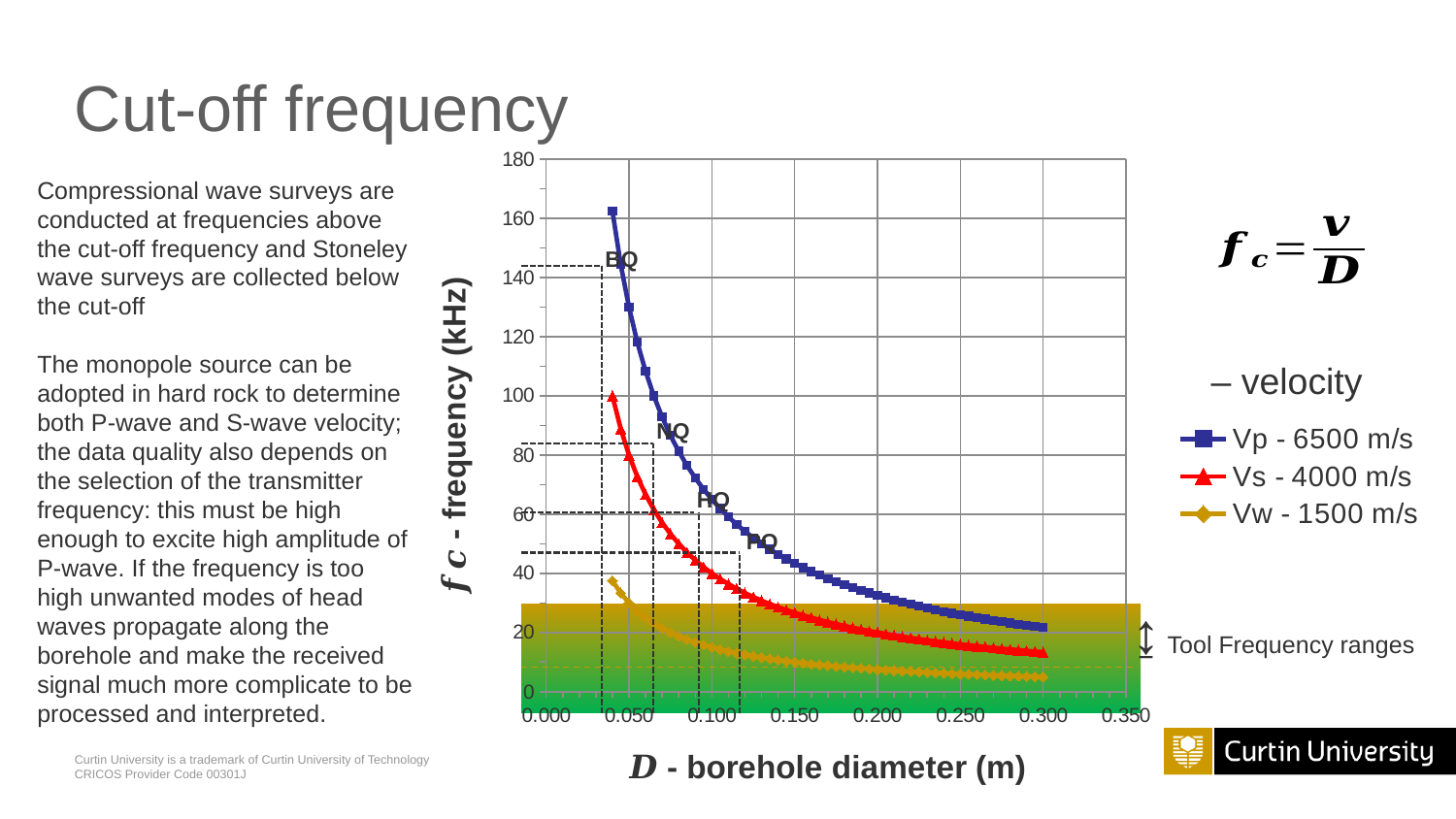
Which series in the chart has the highest frequency values across the borehole diameters? Vp - 6500 m/s What kind of chart is shown on the slide? line chart What is the title of the y axis of the chart? fc - frequency (kHz) At a borehole diameter of 0.200 m, which series has the larger frequency, Vp - 6500 m/s or Vs - 4000 m/s? Vp - 6500 m/s Is the value for Vw - 1500 m/s at a borehole diameter of 0.300 m greater or less than 20 kHz? less How many series does the chart legend list? 3 Do the cut-off frequency values rise or fall as the borehole diameter increases? fall Is the value for Vp - 6500 m/s at a borehole diameter of 0.050 m greater or less than 120 kHz? greater Which series in the chart has the lowest frequency values across the borehole diameters? Vw - 1500 m/s What is the title of the x axis of the chart? D - borehole diameter (m) Is the value for Vs - 4000 m/s at a borehole diameter of 0.300 m greater or less than 20 kHz? less